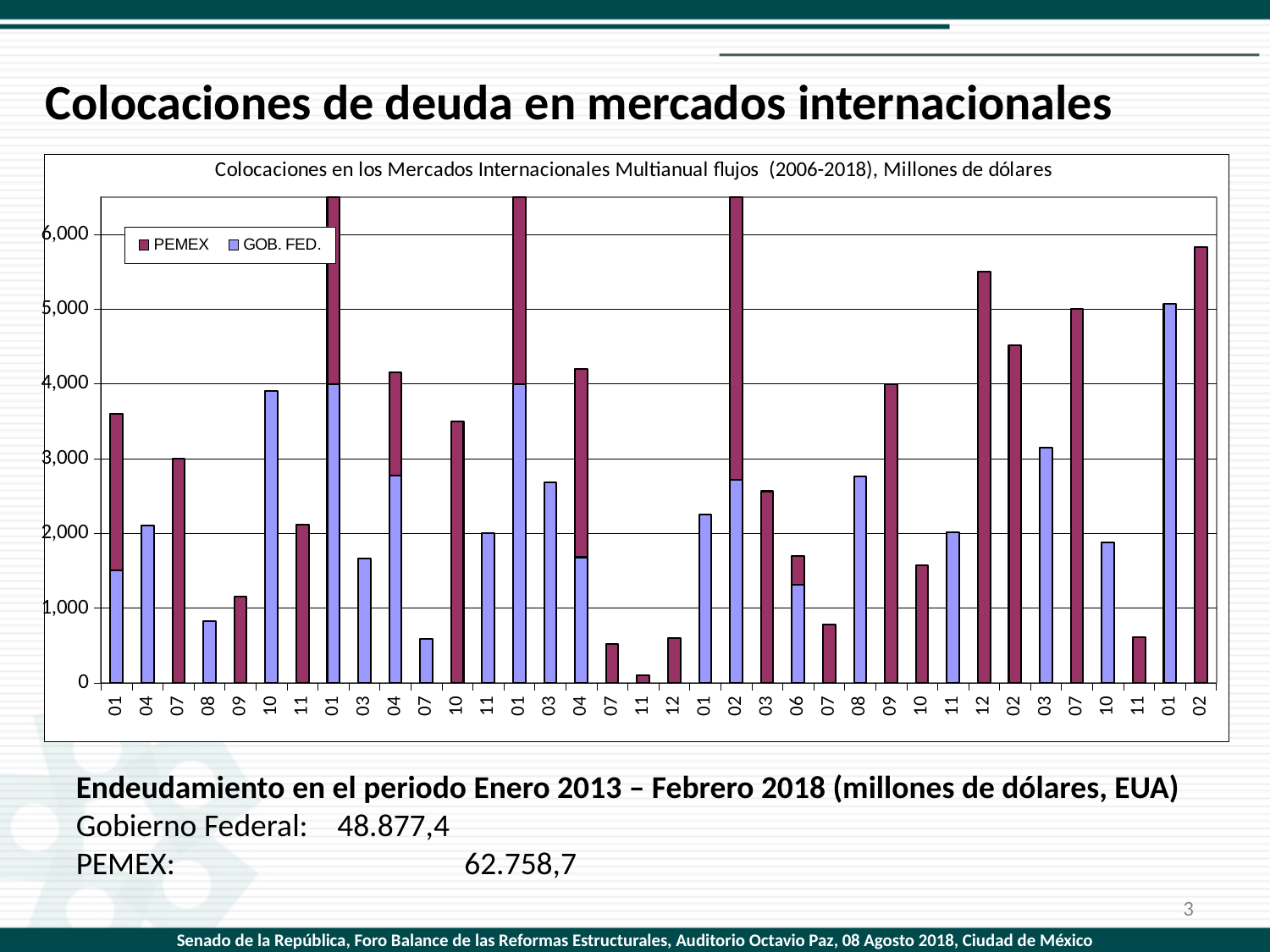
Which is larger: the bar labelled 06 or the fourth bar from the left labelled 08? The bar labelled 06 Which is larger: the first (leftmost) bar labelled 01 or the last (rightmost) bar labelled 02? The last bar labelled 02 Is the value of the bar labelled 06 greater or less than 2,000? less What are the two series named in the chart legend? PEMEX and GOB. FED. What is the title of the chart? Colocaciones en los Mercados Internacionales Multianual flujos (2006-2018), Millones de dólares Is the value of the first (leftmost) bar, labelled 01, greater or less than 3,000? greater Is the value of the last (rightmost) bar, labelled 02, greater or less than 5,000? greater How many bars are plotted along the x axis of the chart? 36 What kind of chart is shown on the slide? Stacked bar chart What is the highest value shown on the chart's vertical axis? 6,000 How many series does the chart legend list? 2